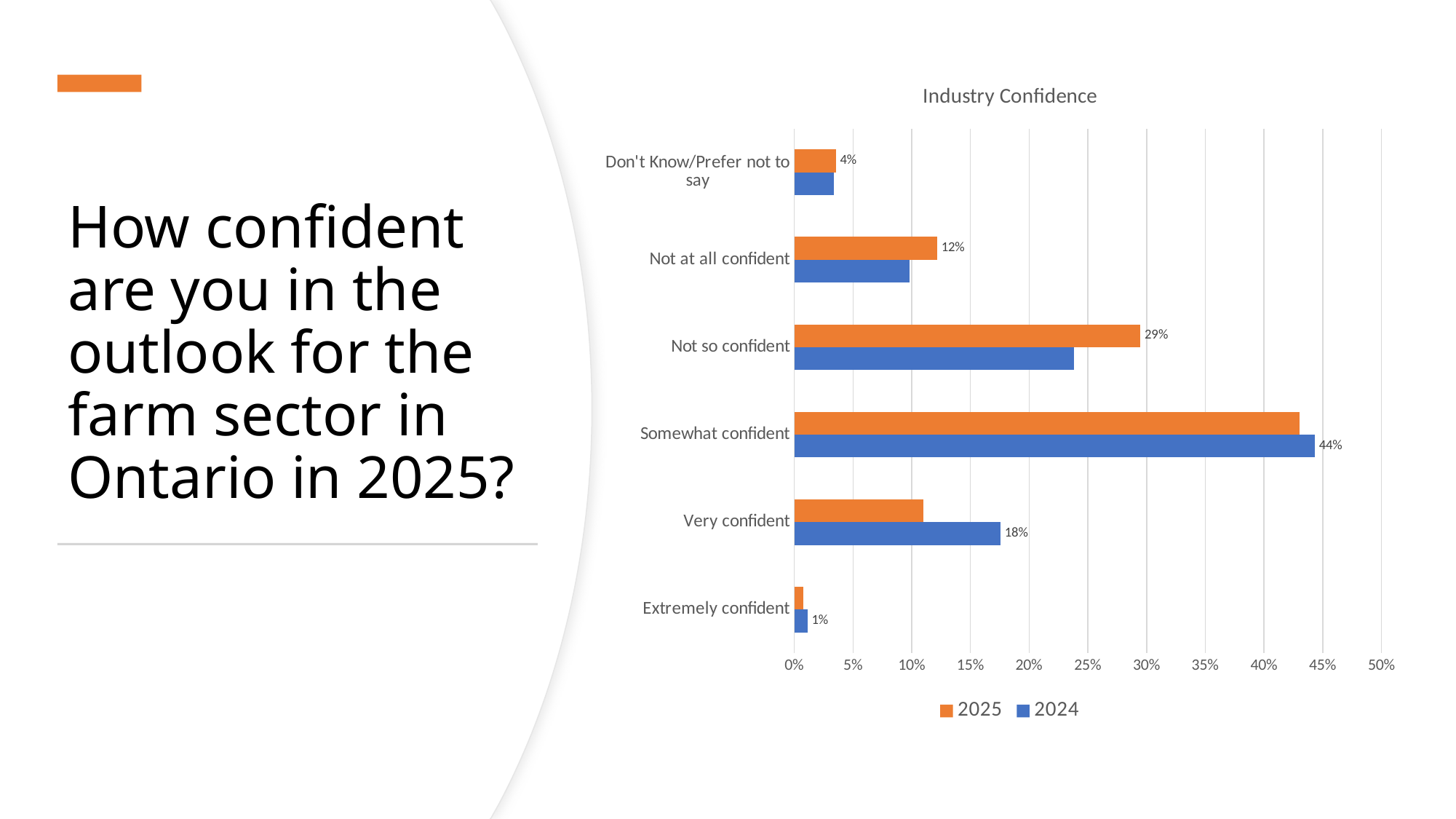
In the Industry Confidence chart, what is the 2025 value for Don't Know/Prefer not to say? 4% In the Industry Confidence chart, what is the 2024 value for Extremely confident? 1% In the Industry Confidence chart, which category has the highest 2024 value? Somewhat confident In the Industry Confidence chart, what is the 2025 value for Not so confident? 29% In the Industry Confidence chart, which category has the lowest 2025 value? Extremely confident In the Industry Confidence chart, for Very confident, which year has the larger value, 2024 or 2025? 2024 How many series does the legend of the Industry Confidence chart list? 2 In the Industry Confidence chart, what is the 2025 value for Not at all confident? 12% How many categories are shown in the Industry Confidence chart? 6 In the Industry Confidence chart, is the 2024 value for Not so confident greater or less than 20%? greater In the Industry Confidence chart, what is the 2024 value for Somewhat confident? 44% In the Industry Confidence chart, what is the 2024 value for Very confident? 18%